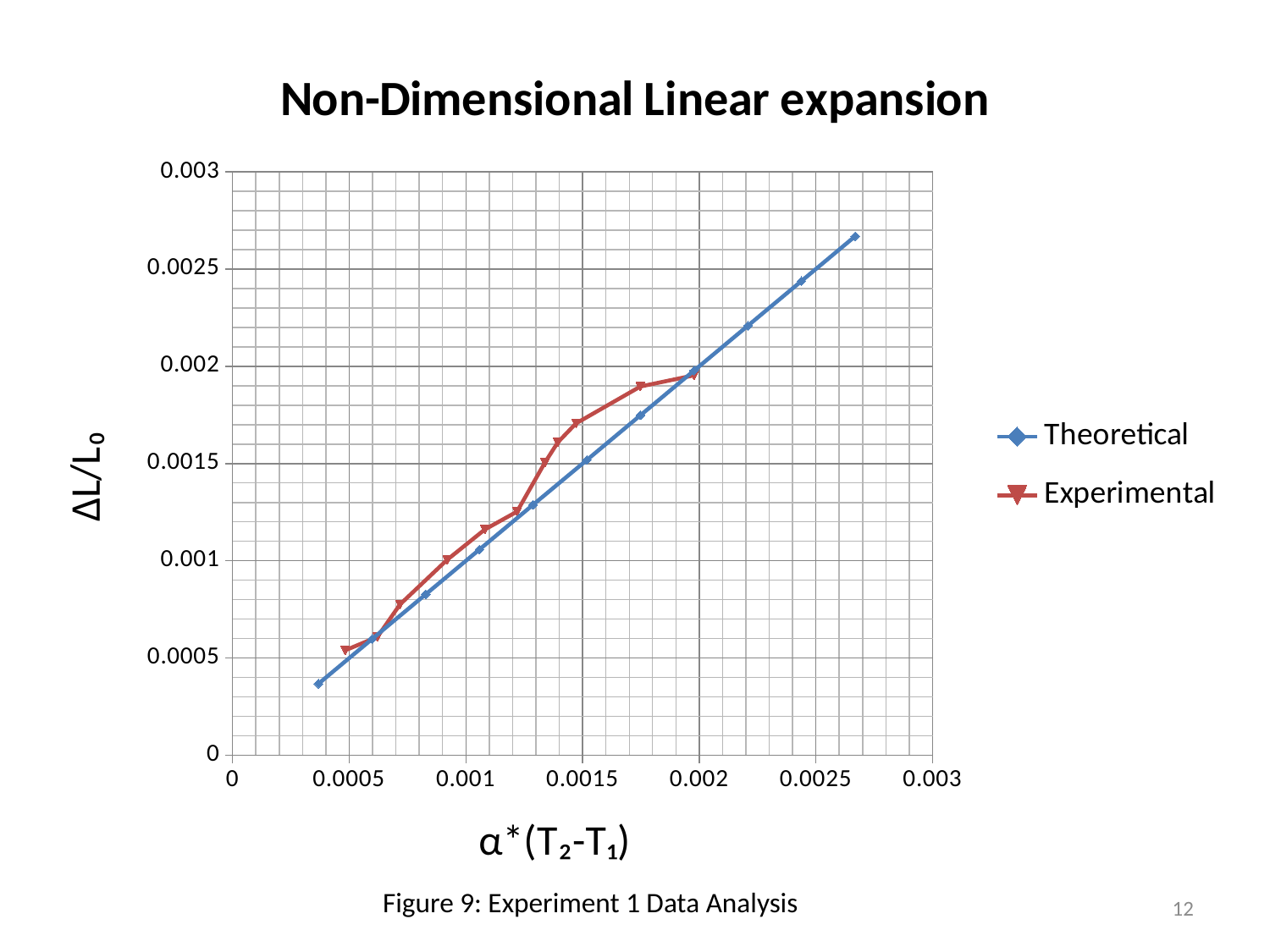
Which series reaches the higher maximum ΔL/L₀ value, Theoretical or Experimental? Theoretical Is the lowest Theoretical value greater or less than 0.0005? less What is the title of the chart? Non-Dimensional Linear expansion Is the highest Experimental value greater or less than 0.0025? less Is the lowest Experimental value greater or less than 0.0005? greater Do the Theoretical values rise or fall as α*(T₂-T₁) increases? rise Do the Experimental values rise or fall as α*(T₂-T₁) increases? rise What kind of chart is shown on the slide? line chart At α*(T₂-T₁) of about 0.0015, which series has the larger ΔL/L₀ value, Theoretical or Experimental? Experimental What are the two series named in the legend? Theoretical and Experimental How many series does the legend list? 2